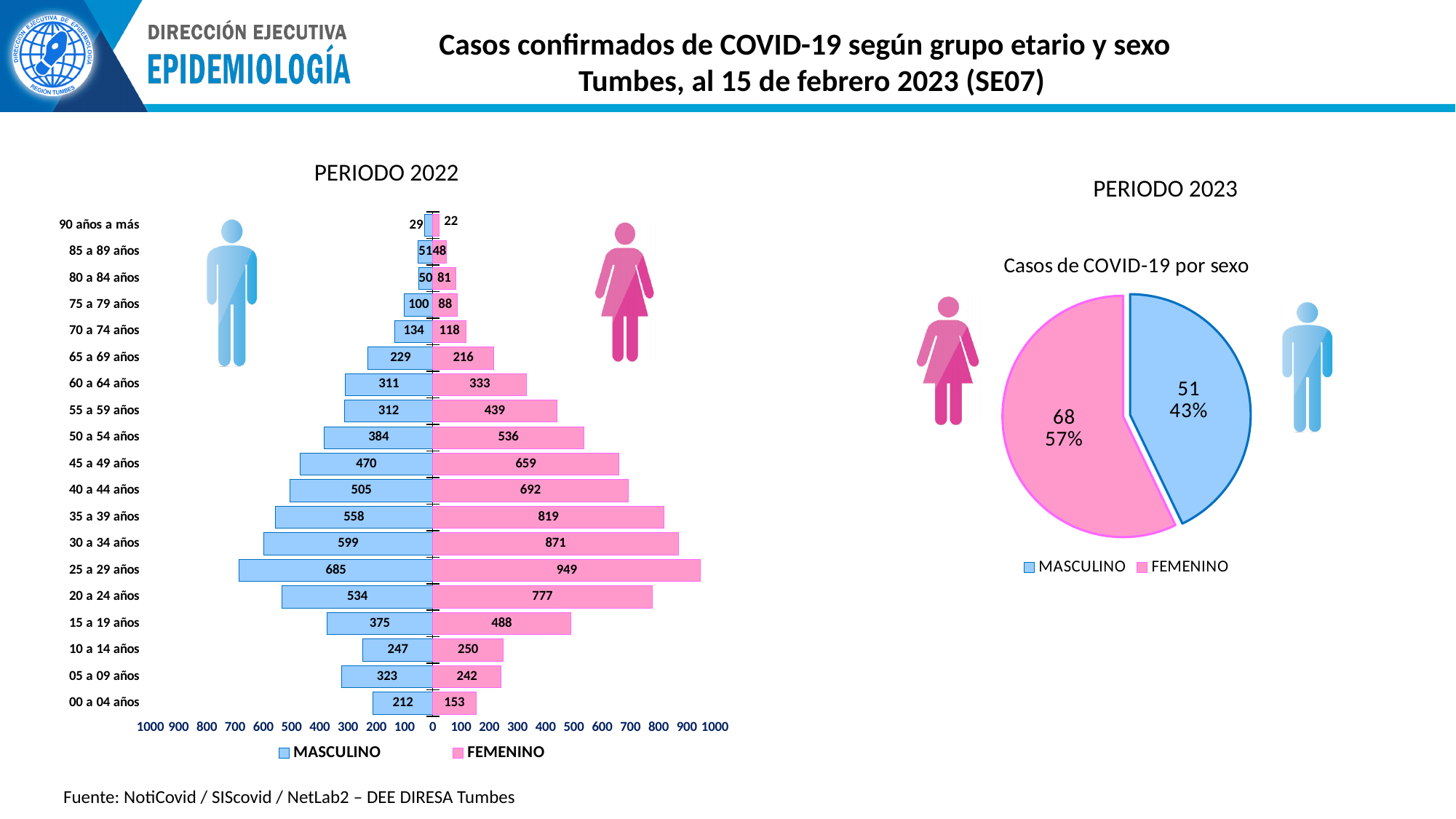
What kind of chart is the PERIODO 2023 chart? Pie chart In the PERIODO 2022 chart, which is larger for 05 a 09 años, MASCULINO or FEMENINO? MASCULINO In the PERIODO 2022 chart, what is the MASCULINO value for 25 a 29 años? 685 What kind of chart is the PERIODO 2022 chart? Bar chart In the PERIODO 2022 chart, what is the FEMENINO value for 30 a 34 años? 871 In the PERIODO 2022 chart, how many series does the legend list? 2 In the PERIODO 2022 chart, which age group has the highest FEMENINO value? 25 a 29 años In the PERIODO 2023 pie chart, what share of cases is FEMENINO? 57% In the PERIODO 2023 pie chart, what is the MASCULINO value? 51 In the PERIODO 2022 chart, which age group has the lowest MASCULINO value? 90 años a más In the PERIODO 2022 chart, how many age groups are shown? 19 In the PERIODO 2022 chart, what is the difference between the FEMENINO and MASCULINO values for 20 a 24 años? 243